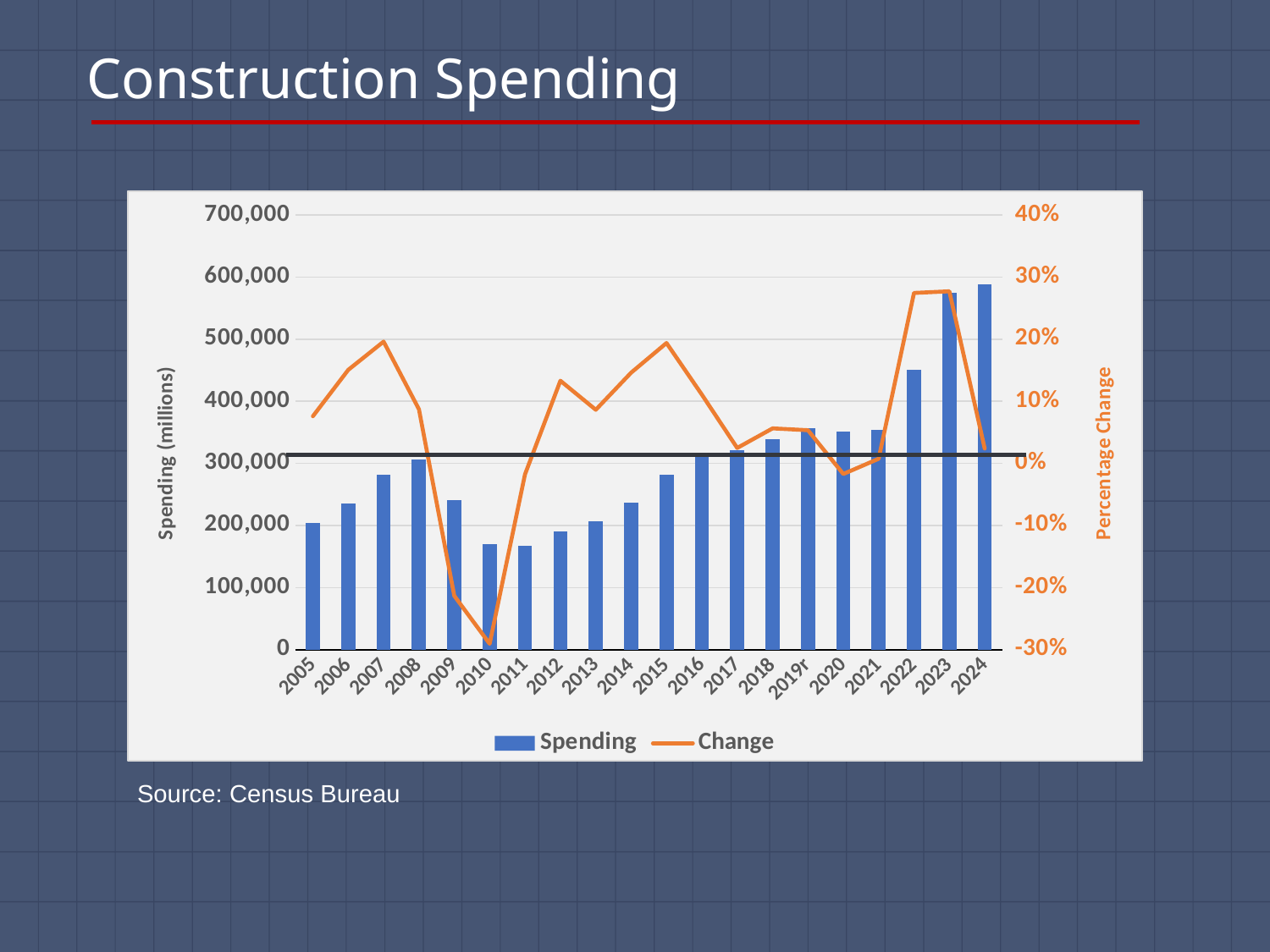
Is the Change value for 2022 greater or less than 20%? greater Which year has the lowest value on the Change line? 2010 Is the Spending value for 2023 greater or less than 500,000? greater Is the Spending value for 2005 greater or less than 300,000? less How many years are shown along the x axis? 20 How many series does the legend list? 2 What kind of chart is shown on the slide? A bar chart combined with a line chart Does Spending rise or fall from 2020 to 2024? rise Which year has the larger Spending bar, 2016 or 2022? 2022 Which year has the highest Spending bar? 2024 What are the two series named in the legend? Spending and Change